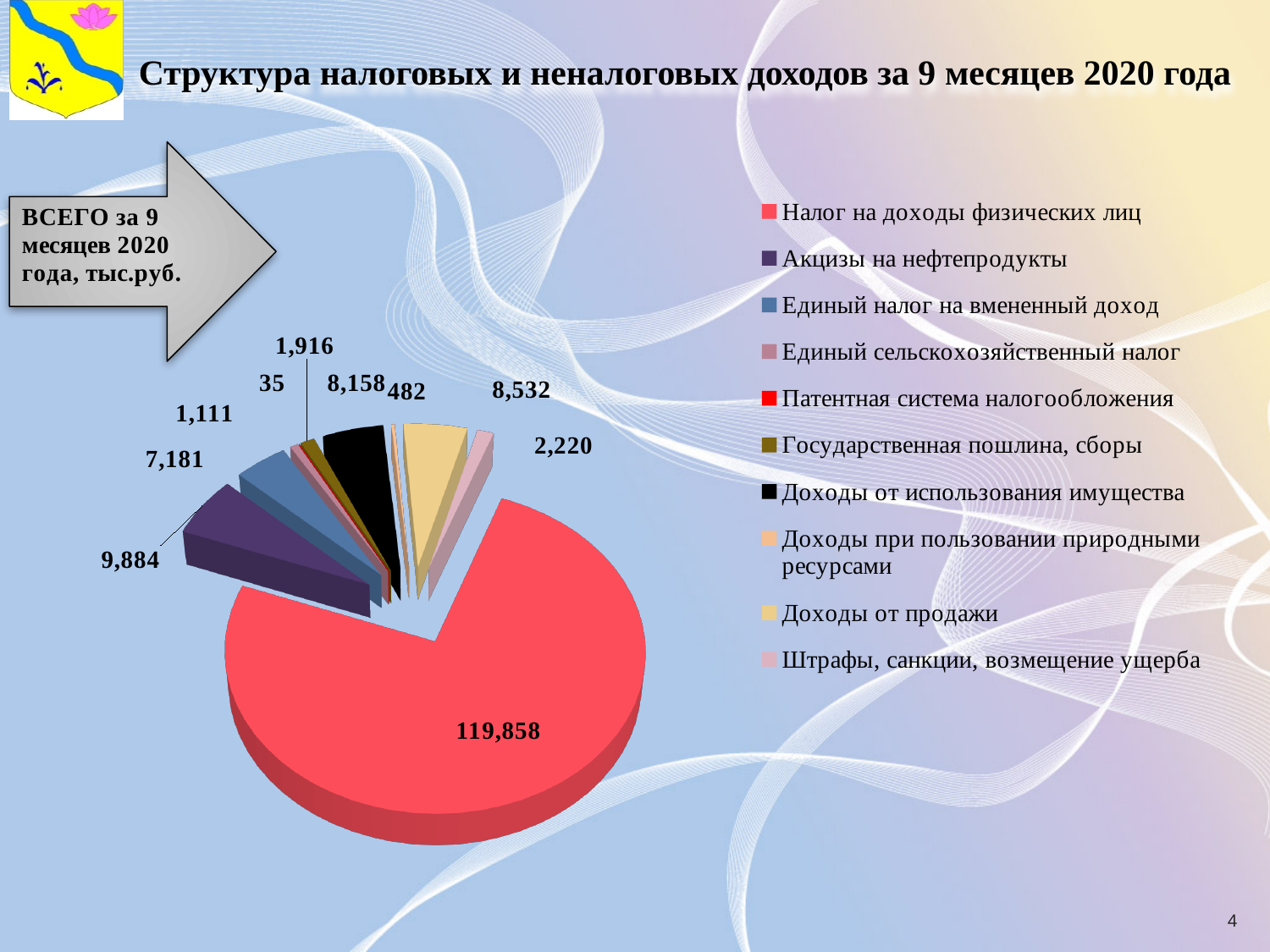
What is the difference between the values for Акцизы на нефтепродукты and Единый налог на вмененный доход? 2,703 Which is larger: Доходы от продажи or Доходы от использования имущества? Доходы от продажи What is the value for Патентная система налогообложения? 35 What kind of chart is shown on the slide? pie chart What is the value for Акцизы на нефтепродукты? 9,884 What is the value for Доходы от продажи? 8,532 What is the title of the slide containing the chart? Структура налоговых и неналоговых доходов за 9 месяцев 2020 года Which category has the smallest value? Патентная система налогообложения What is the value for Штрафы, санкции, возмещение ущерба? 2,220 Which category has the largest slice of the pie? Налог на доходы физических лиц What is the value for Налог на доходы физических лиц? 119,858 How many categories does the pie chart have? 10